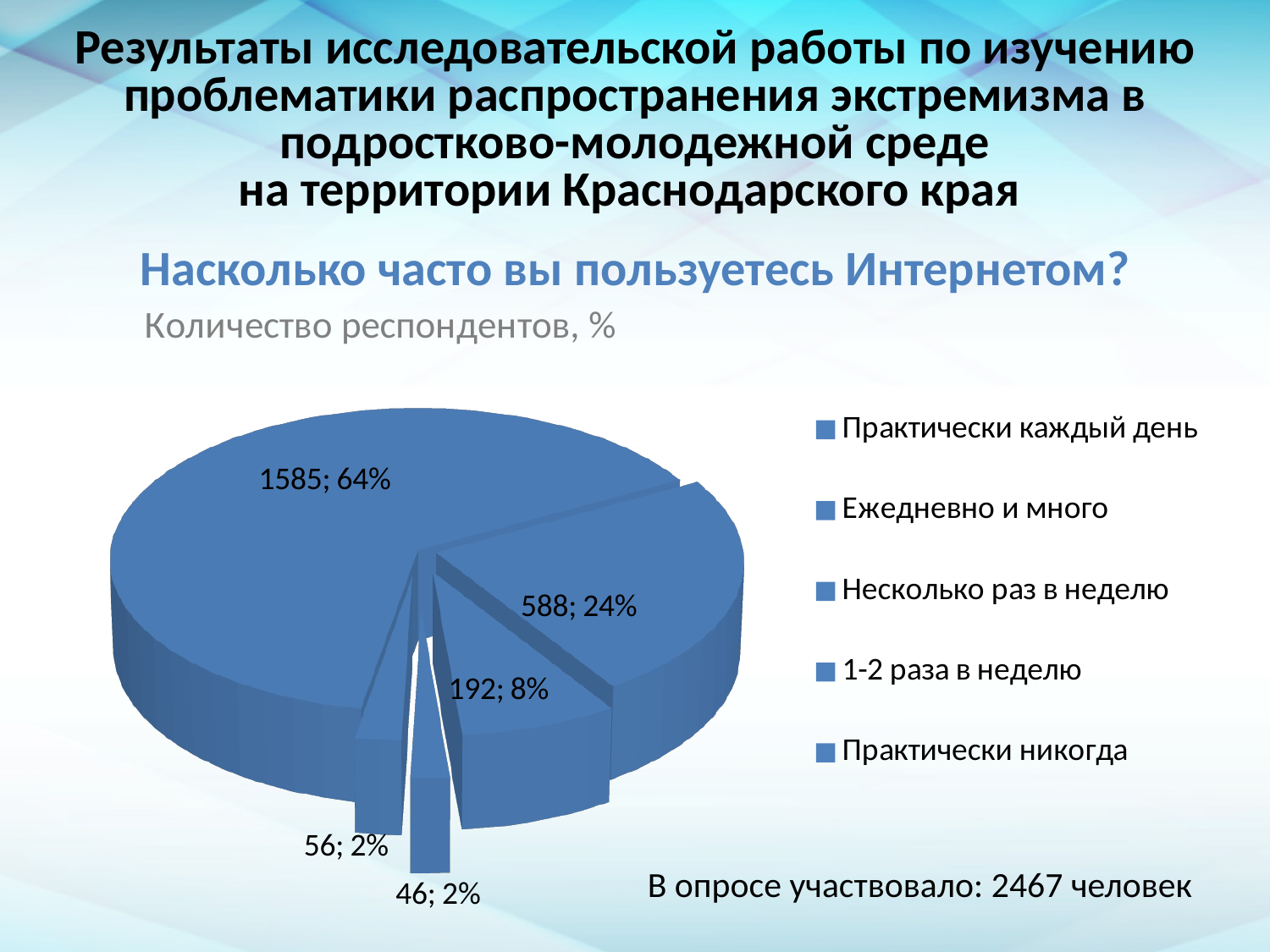
How many entries does the legend of the pie chart list? 5 Which slice is larger: the one labelled 192 or the one labelled 56? 192 What is the first entry listed in the chart legend? Практически каждый день What percentage share is shown for the slice labelled 192? 8% What percentage share is shown for the slice labelled 588? 24% What is the total of all the slice values shown on the pie chart? 2467 What question does the chart title ask? Насколько часто вы пользуетесь Интернетом? What is the value shown on the smallest slice of the pie chart? 46 What is the value and share shown on the largest slice of the pie chart? 1585; 64% How many slices does the pie chart have? 5 What kind of chart is shown on the slide? pie chart What is the difference between the slice labelled 1585 and the slice labelled 588? 997